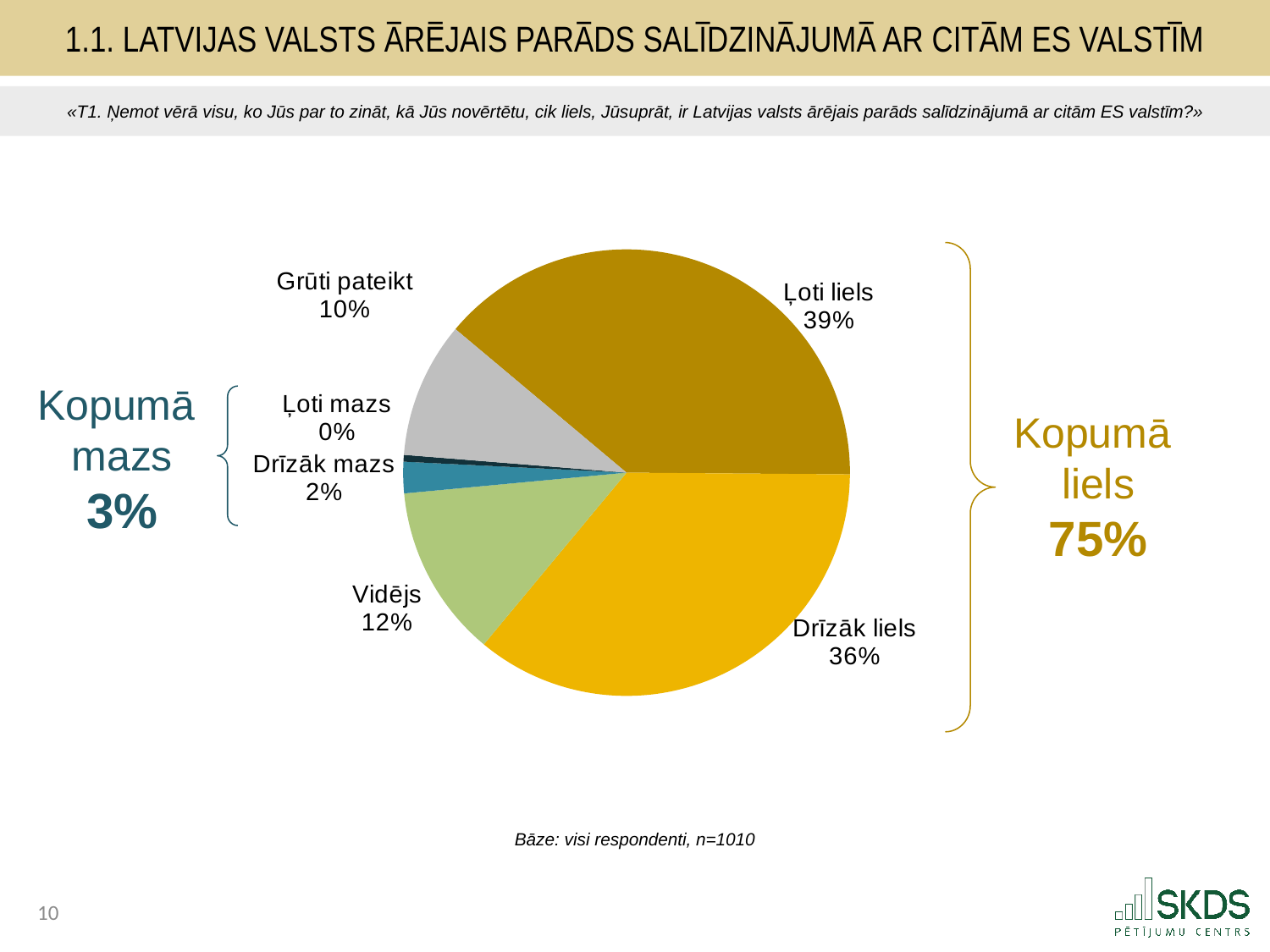
Which is larger, the share for "Vidējs" or the share for "Grūti pateikt"? Vidējs What is the difference between the shares for "Ļoti liels" and "Drīzāk liels"? 3% What is the combined share labelled "Kopumā liels" on the slide? 75% How many categories are shown in the pie chart? 6 What percentage of respondents answered "Ļoti liels"? 39% What percentage of respondents answered "Grūti pateikt"? 10% What kind of chart is shown on the slide? pie chart What percentage of respondents answered "Ļoti mazs"? 0% Which category has the smallest share of the pie? Ļoti mazs What percentage of respondents answered "Vidējs"? 12% What percentage of respondents answered "Drīzāk liels"? 36% Which category has the largest share of the pie? Ļoti liels